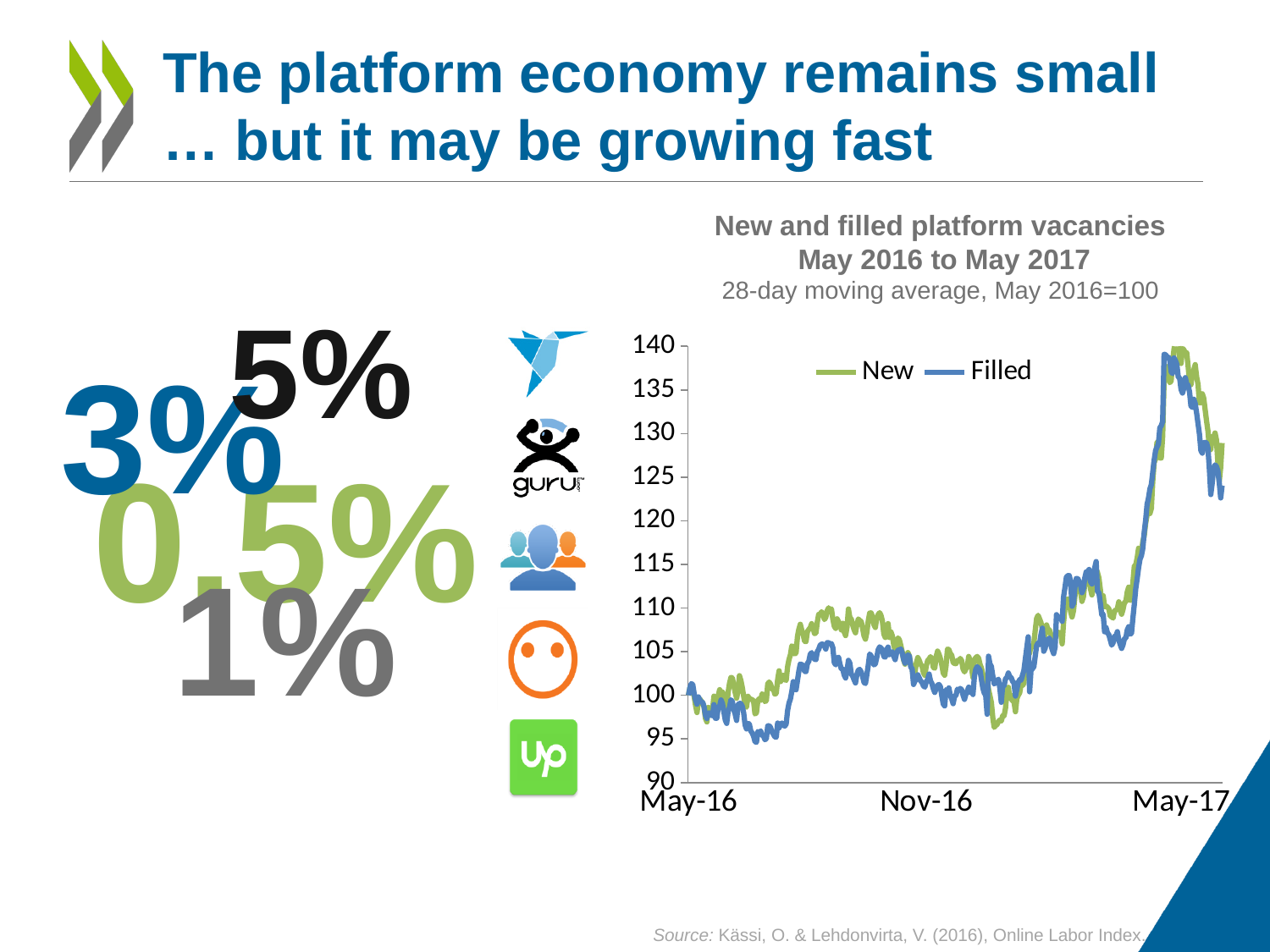
Is the value of the New series at Nov-16 greater or less than 100? greater Is the peak value of the Filled series greater or less than 135? greater How many series does the legend of the chart list? 2 Overall, do the values in the chart rise or fall from May-16 to May-17? rise What kind of chart is shown on the slide? line chart Is the value of the Filled series at Nov-16 greater or less than 110? less What is the title of the chart? New and filled platform vacancies May 2016 to May 2017 What are the two series shown in the chart's legend? New and Filled